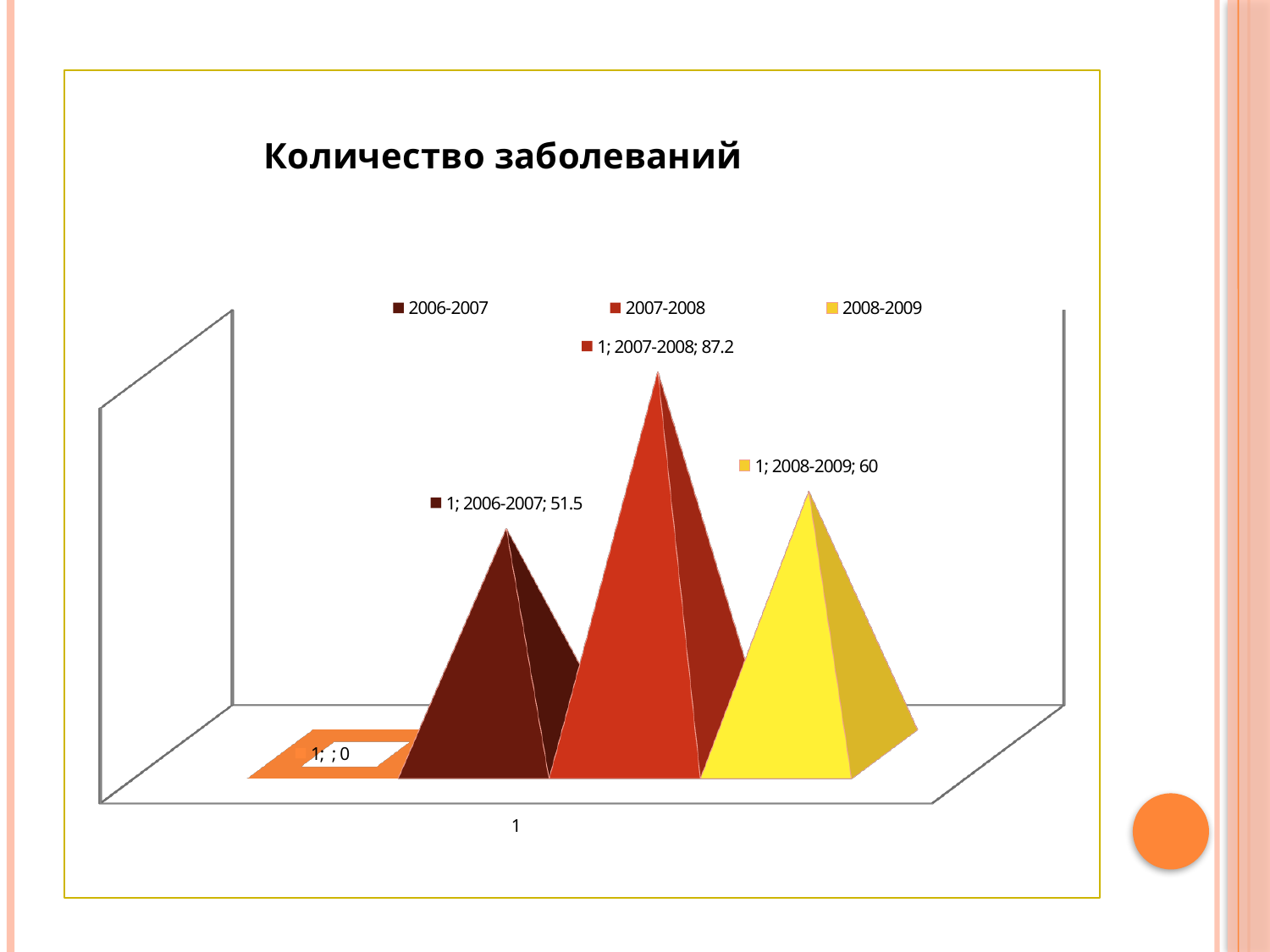
What kind of chart is shown on the slide? bar chart What is the value for the 2007-2008 series? 87.2 How many series does the legend list? 3 What is the difference between the 2007-2008 value and the 2006-2007 value? 35.7 Which of the three labelled series has the lowest value? 2006-2007 What is the title of the chart? Количество заболеваний What is the value for the 2006-2007 series? 51.5 What is the difference between the 2008-2009 value and the 2006-2007 value? 8.5 What is the value for the 2008-2009 series? 60 Which series has the highest value? 2007-2008 Which is larger, the value for 2008-2009 or the value for 2006-2007? 2008-2009 What colour is the 2008-2009 series in the legend? yellow